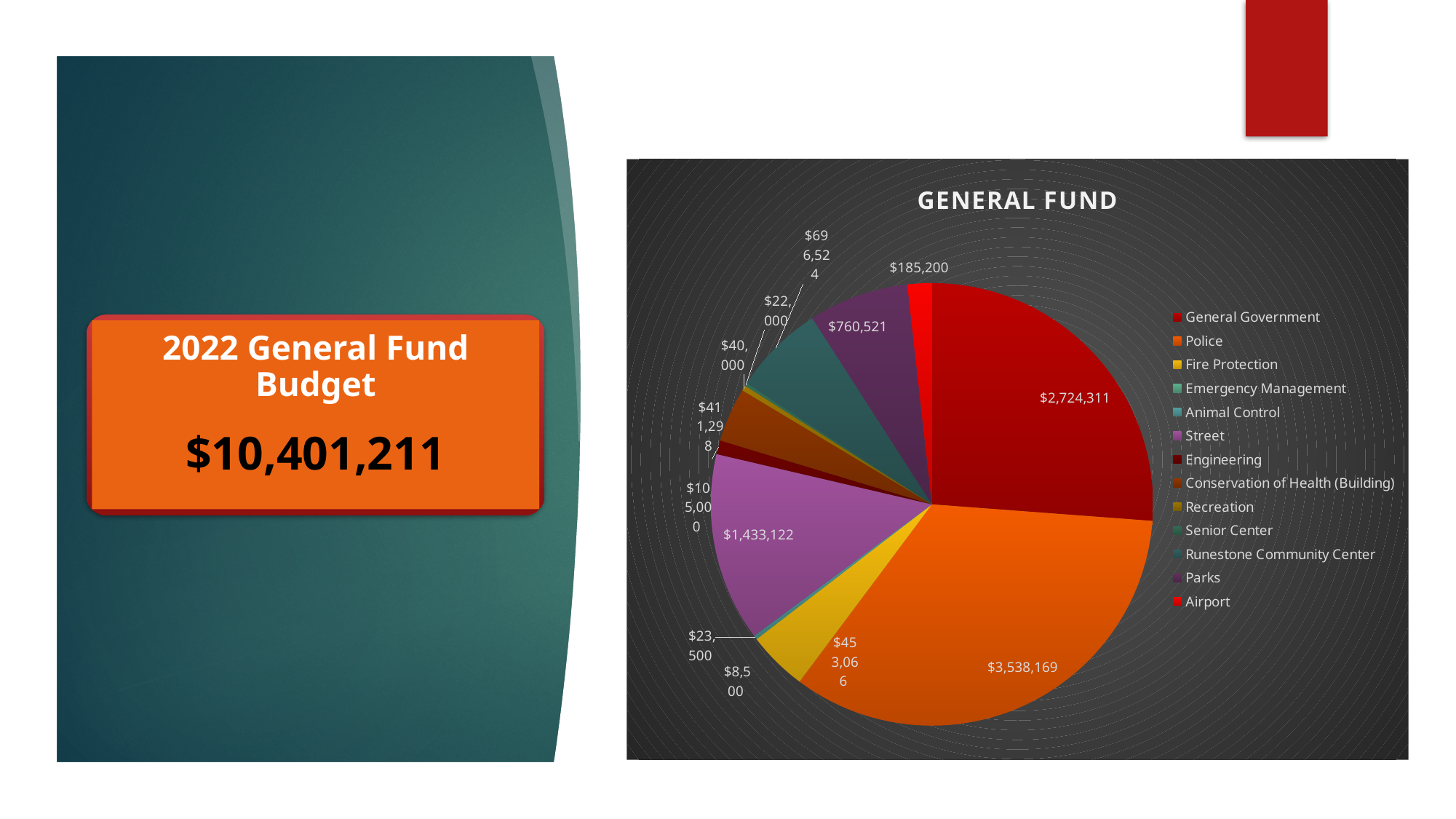
What is the value for Police in the General Fund pie chart? $3,538,169 Which category has the smallest slice in the General Fund pie chart? Emergency Management What is the title of the chart? GENERAL FUND Which category has the largest slice in the General Fund pie chart? Police How many categories does the legend of the General Fund pie chart list? 13 How much larger is the Police value than the General Government value? $813,858 What kind of chart is shown on the slide? pie chart What is the value for Airport in the General Fund pie chart? $185,200 What is the value for General Government in the General Fund pie chart? $2,724,311 Which is larger, the Parks slice or the Runestone Community Center slice? Parks What is the value for Parks in the General Fund pie chart? $760,521 What is the value for Street in the General Fund pie chart? $1,433,122